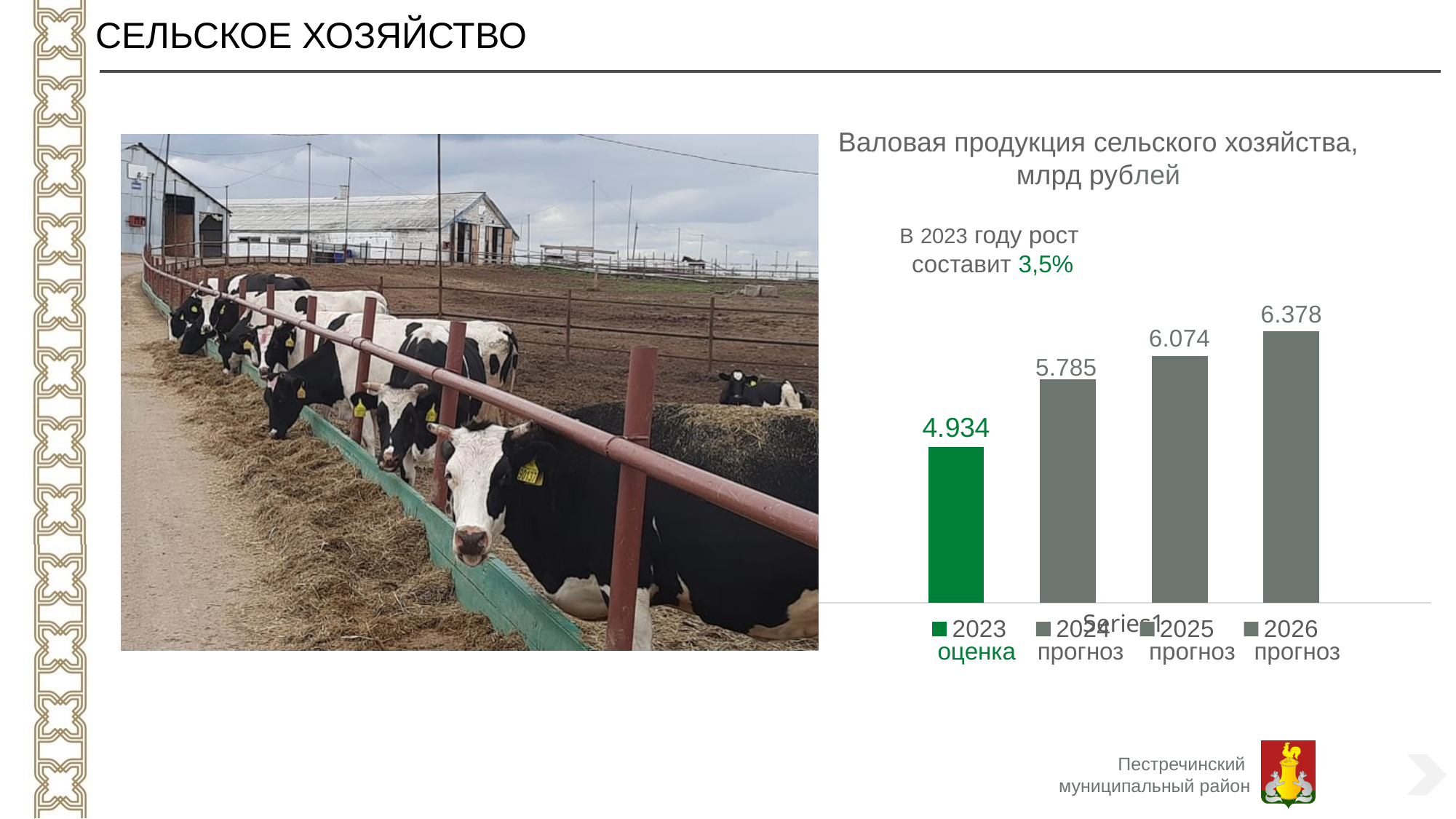
What is the value for 2025 (прогноз) in the chart? 6.074 What is the difference between the 2024 value and the 2023 value? 0.851 What is the value for 2023 (оценка) in the chart 'Валовая продукция сельского хозяйства, млрд рублей'? 4.934 Do the values rise or fall from 2023 to 2026? Rise How many bars are shown in the chart? 4 What kind of chart is shown on the slide? Bar chart What is the value for 2026 (прогноз) in the chart? 6.378 What is the value for 2024 (прогноз) in the chart? 5.785 Which year has the lowest value in the chart? 2023 What is the difference between the 2026 value and the 2023 value? 1.444 Which is larger, the value for 2025 or the value for 2024? 2025 Which year has the highest value in the chart? 2026